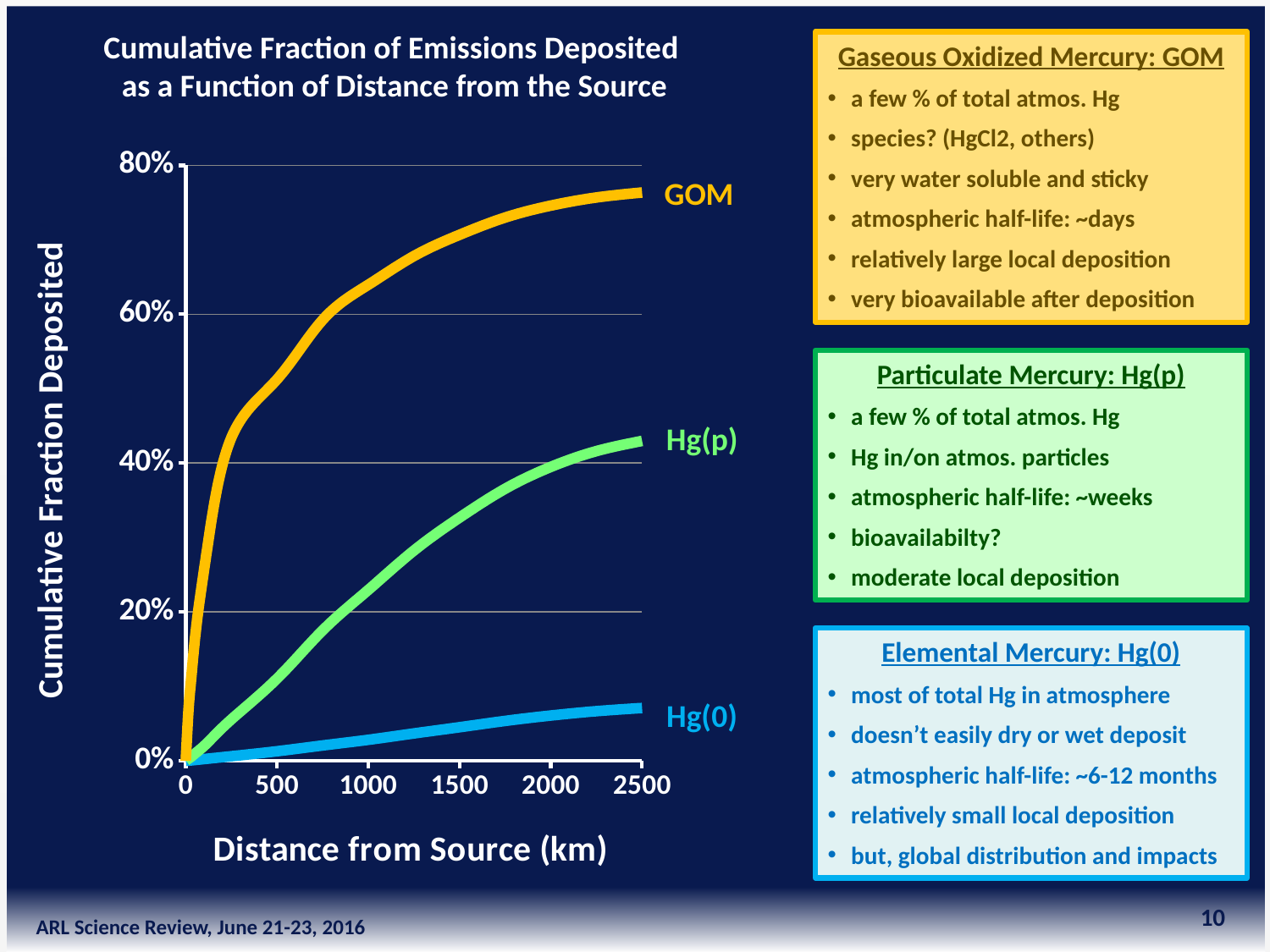
Is the value for GOM at 2500 km greater or less than 60%? greater What kind of chart is shown on the slide? line chart Is the value for GOM at 500 km greater or less than 40%? greater Which series has the lowest cumulative fraction deposited at 2500 km? Hg(0) What is the title of the chart? Cumulative Fraction of Emissions Deposited as a Function of Distance from the Source What is the label of the x axis of the chart? Distance from Source (km) Which series has the highest cumulative fraction deposited at 2500 km? GOM At 1500 km, which series has the larger cumulative fraction deposited, GOM or Hg(p)? GOM Does the cumulative fraction deposited for Hg(p) rise or fall as distance from the source increases? rise How many series are plotted on the chart? 3 Is the value for Hg(0) at 2500 km greater or less than 20%? less